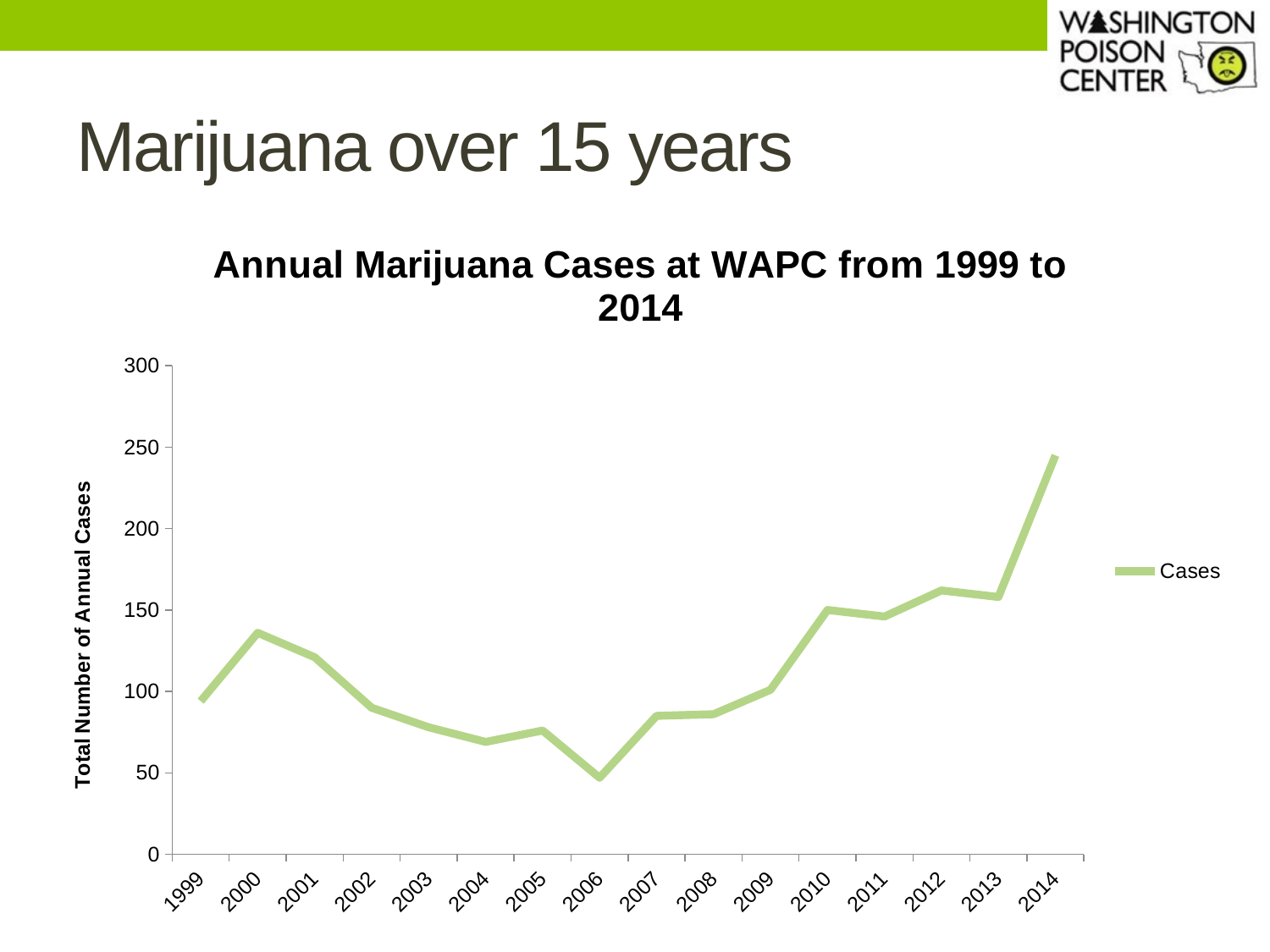
Is the value for 2014 greater or less than 200? greater How many series does the legend list? 1 Is the value for 2004 greater or less than 100? less What is the label on the vertical axis of the chart? Total Number of Annual Cases What is the title of the chart? Annual Marijuana Cases at WAPC from 1999 to 2014 What kind of chart is shown on the slide? Line chart Do the values rise or fall from 2006 to 2014? rise Which year has the highest number of cases? 2014 How many years are plotted along the x axis? 16 Which year has more cases, 2000 or 2002? 2000 Which year has the lowest number of cases? 2006